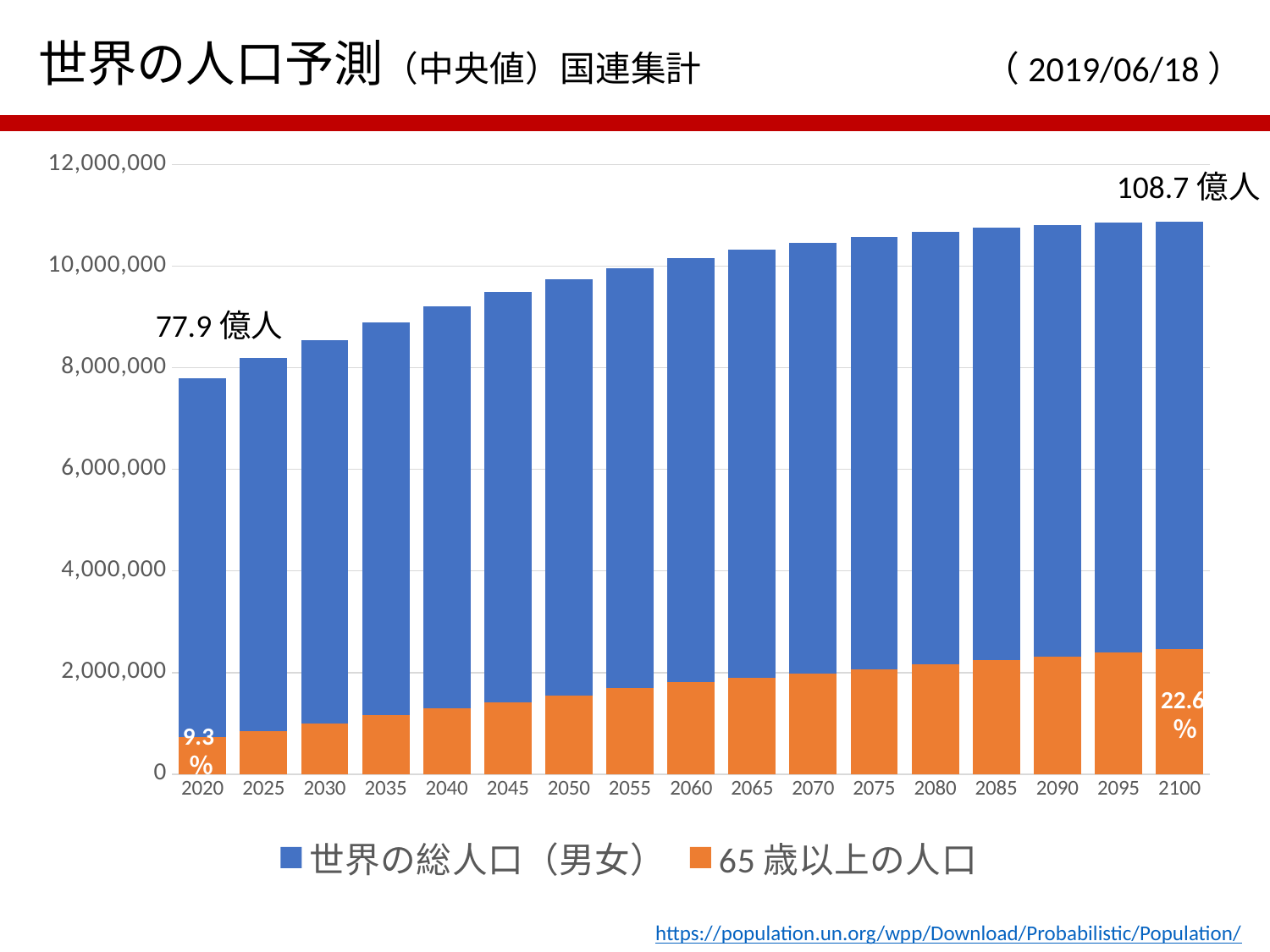
What is the difference between the labelled total population for 2100 and for 2020? 30.8 億人 What percentage is labelled on the 65歳以上の人口 bar for 2020? 9.3% What is the labelled world total population for 2020? 77.9 億人 Does the world total population rise or fall from 2020 to 2100? rise Is the world total population for 2060 greater or less than 10,000,000? greater What percentage is labelled on the 65歳以上の人口 bar for 2100? 22.6% How many series does the legend list? 2 Which year has the highest world total population in the chart? 2100 Which colour represents 65歳以上の人口 in the chart? orange What kind of chart is shown on the slide? bar chart How many years are shown along the x axis of the chart? 17 What is the labelled world total population for 2100? 108.7 億人